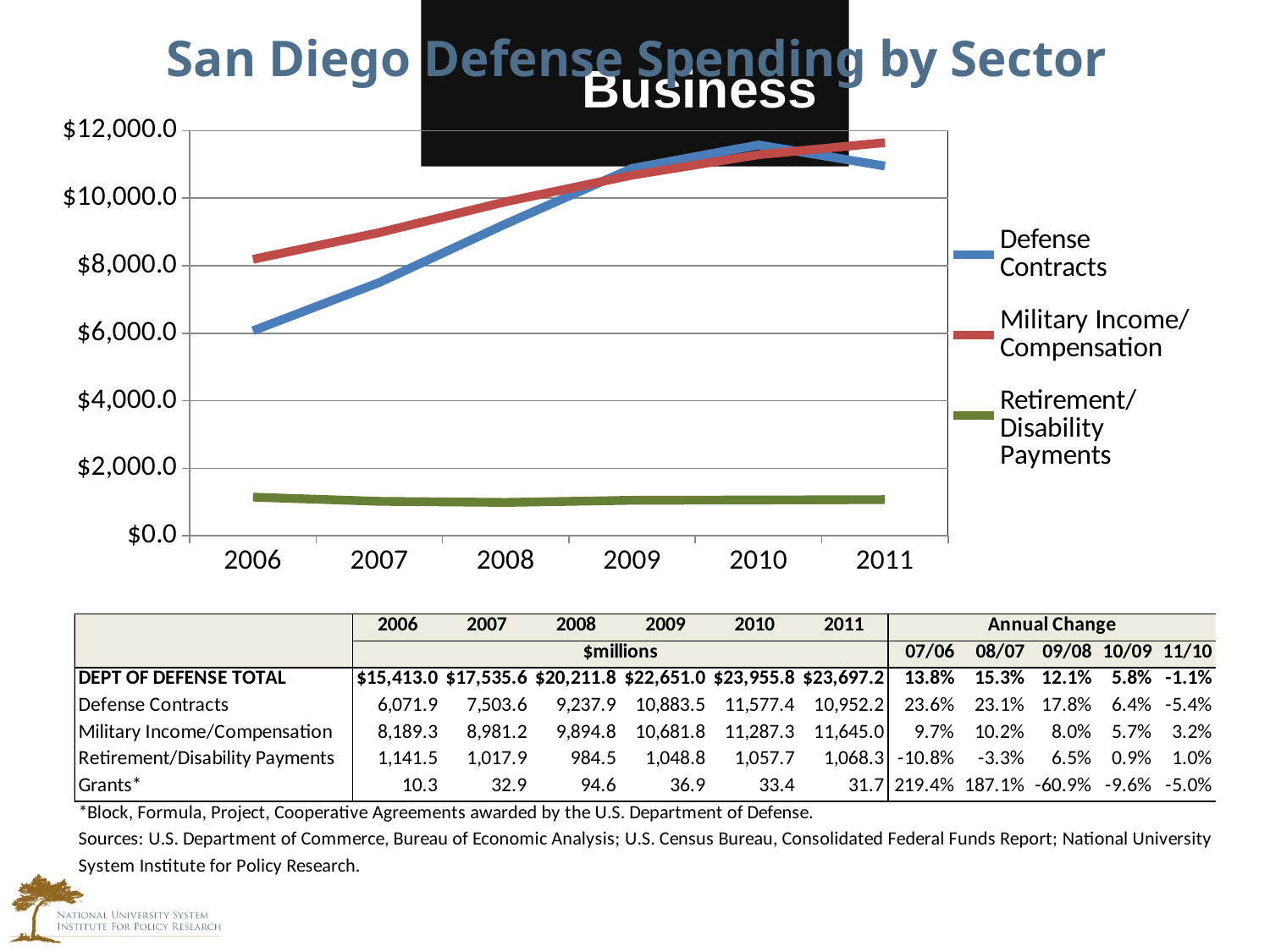
Does the Military Income/Compensation line rise or fall from 2006 to 2011? Rises According to the table, what was the value for Military Income/Compensation in 2009? 10,681.8 How many series does the chart's legend list? 3 In which year did Defense Contracts reach its highest value? 2010 According to the table, what was the value for Retirement/Disability Payments in 2011? 1,068.3 Is the value for Retirement/Disability Payments in 2008 greater or less than $2,000.0? less According to the table, what was the value for Defense Contracts in 2010? 11,577.4 Which series has the lowest values across all years in the chart? Retirement/Disability Payments How many years are plotted along the x axis of the chart? 6 In 2011, which is larger: Defense Contracts or Military Income/Compensation? Military Income/Compensation What kind of chart is shown on the slide? Line chart Using the table values, what is the difference between Military Income/Compensation and Defense Contracts in 2011? 692.8